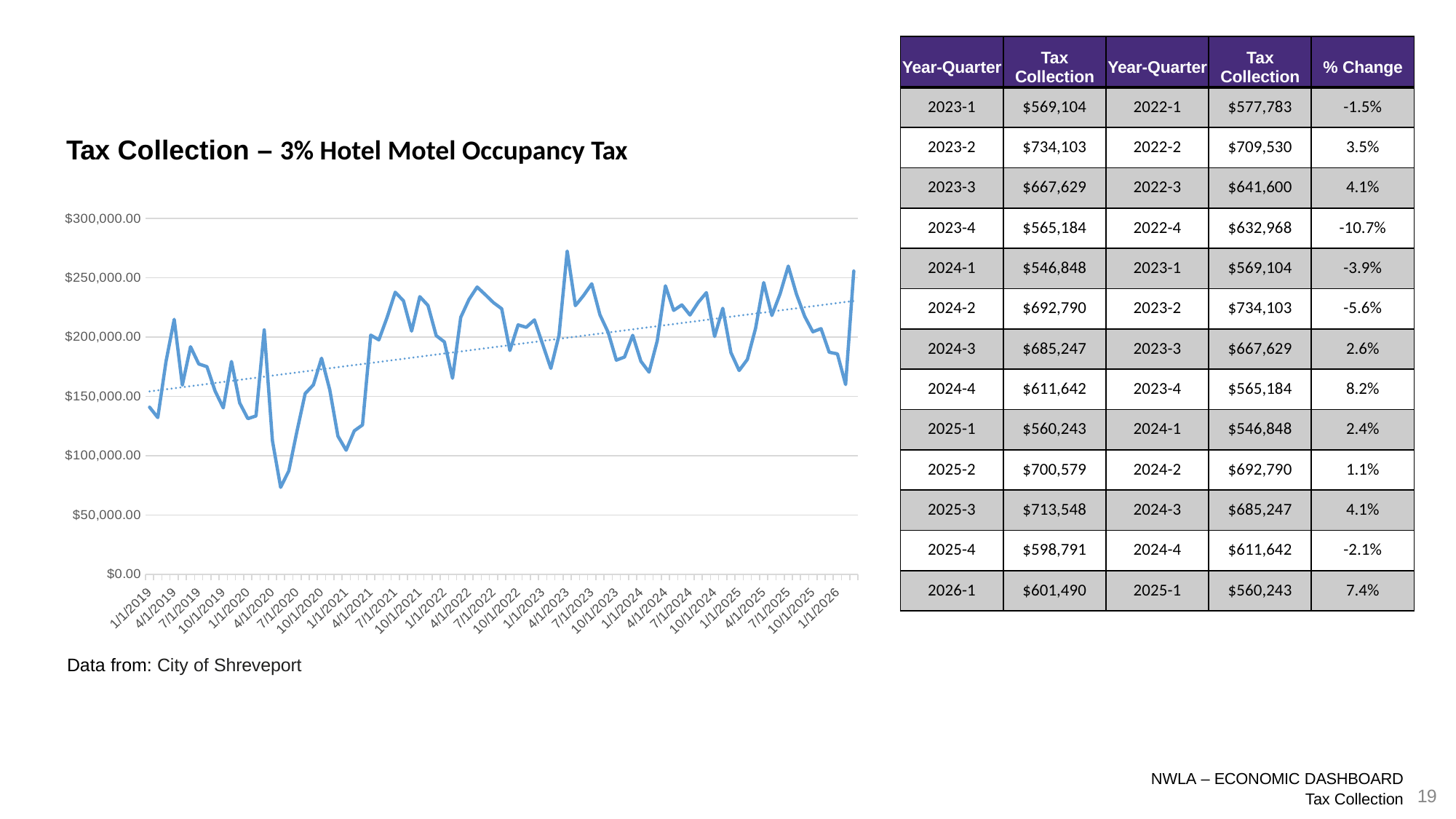
Is the value for 1/1/2026 greater or less than $200,000.00? less What is the title of the chart? Tax Collection – 3% Hotel Motel Occupancy Tax Is the highest value plotted on the chart greater or less than $250,000.00? greater In which year does the chart's lowest point occur? 2020 In which year does the chart's highest point occur? 2023 Is the lowest value plotted on the chart greater or less than $100,000.00? less According to the dotted trendline, do the tax collection values generally rise or fall from 2019 to 2026? rise What is the highest value shown on the chart's vertical axis? $300,000.00 What kind of chart is shown on the slide? line chart